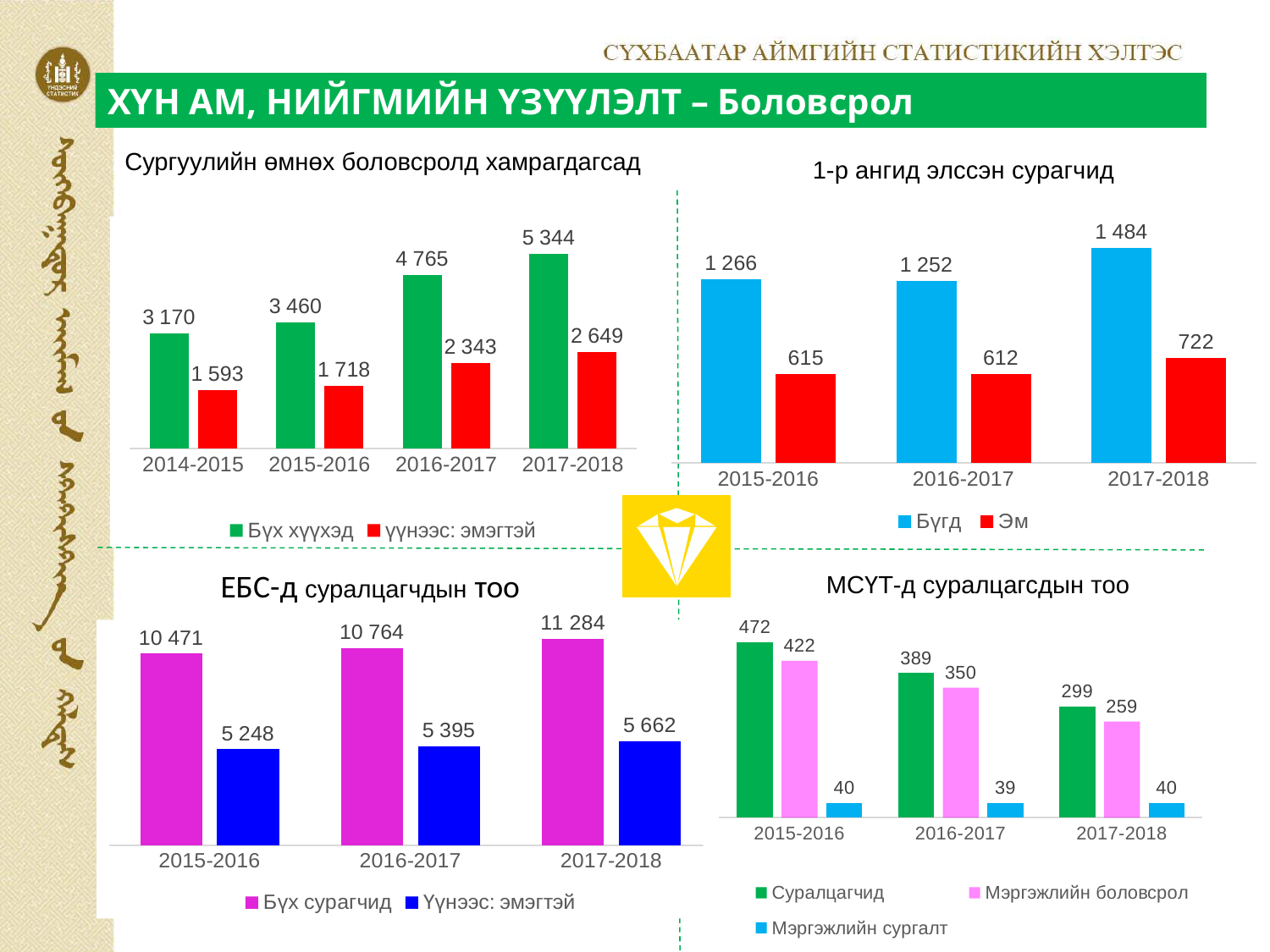
In the chart titled 'ЕБС-д суралцагчдын тоо', do the values for 'Бүх сурагчид' rise or fall from 2015-2016 to 2017-2018? rise In the chart titled 'ЕБС-д суралцагчдын тоо', what is the value for 'Үүнээс: эмэгтэй' in 2016-2017? 5 395 In the chart titled 'МСҮТ-д суралцагсдын тоо', which year has the lowest value for 'Суралцагчид'? 2017-2018 What type of chart is the chart titled 'МСҮТ-д суралцагсдын тоо'? bar chart In the chart titled '1-р ангид элссэн сурагчид', which is larger: 'Бүгд' in 2015-2016 or 'Бүгд' in 2017-2018? 2017-2018 In the chart titled 'МСҮТ-д суралцагсдын тоо', what is the value for 'Мэргэжлийн боловсрол' in 2017-2018? 259 In the chart titled 'Сургуулийн өмнөх боловсролд хамрагдагсад', how many categories are shown on the x axis? 4 In the chart titled '1-р ангид элссэн сурагчид', what is the value for 'Эм' in 2016-2017? 612 In the chart titled 'ЕБС-д суралцагчдын тоо', how many series does the legend list? 2 In the chart titled 'Сургуулийн өмнөх боловсролд хамрагдагсад', what is the value for 'Бүх хүүхэд' in 2017-2018? 5 344 In the chart titled '1-р ангид элссэн сурагчид', which year has the highest value for 'Бүгд'? 2017-2018 In the chart titled 'Сургуулийн өмнөх боловсролд хамрагдагсад', what is the difference between 'Бүх хүүхэд' and 'үүнээс: эмэгтэй' in 2014-2015? 1 577